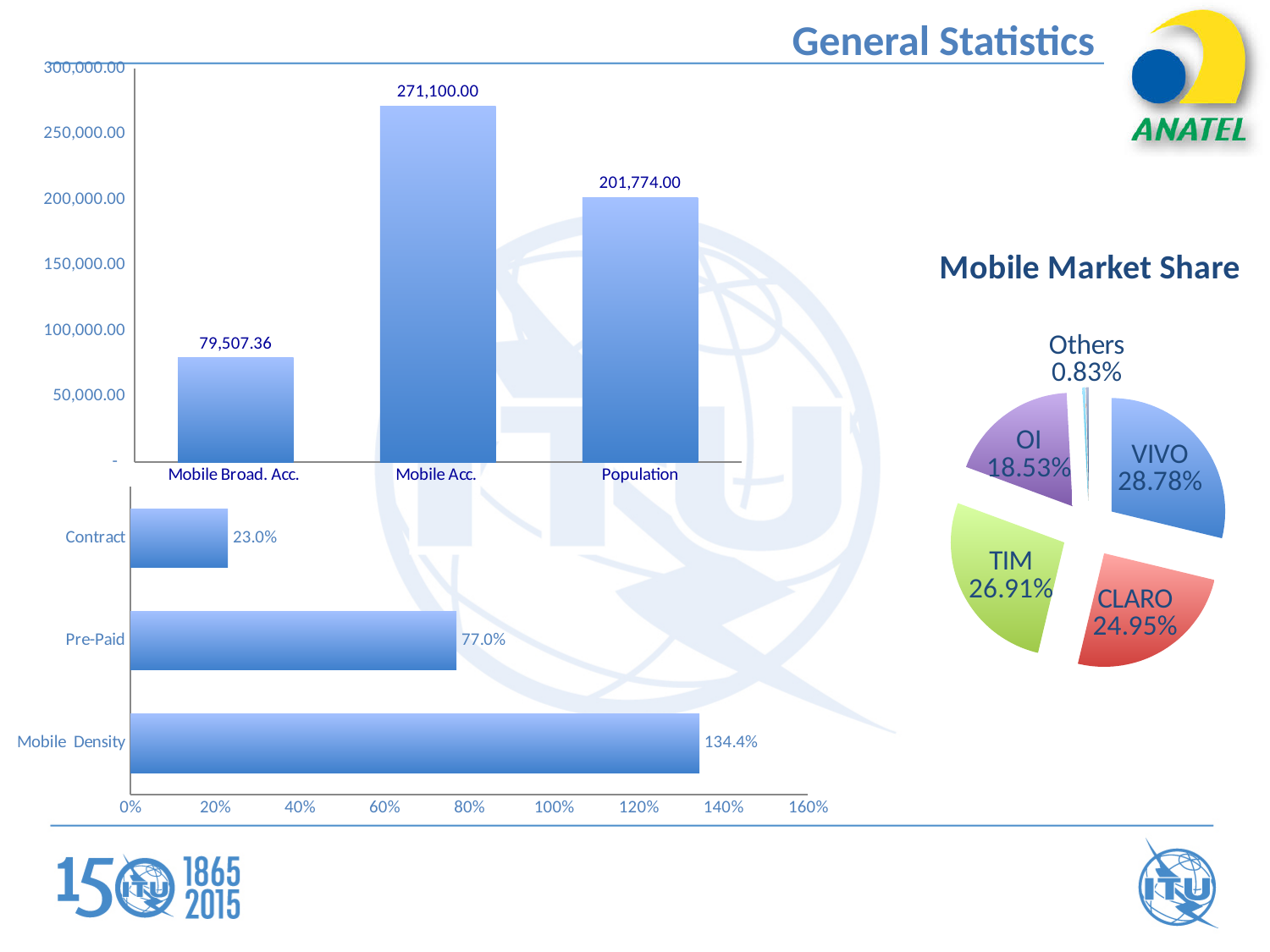
In the Mobile Market Share pie chart, which slice is the largest? VIVO In the top-left vertical bar chart, what is the difference between Mobile Acc. and Population? 69,326.00 In the top-left vertical bar chart, what is the value for Mobile Acc.? 271,100.00 In the bottom-left horizontal bar chart, what kind of chart is it? bar chart In the top-left vertical bar chart, what is the value for Mobile Broad. Acc.? 79,507.36 In the Mobile Market Share pie chart, which is larger, CLARO or OI? CLARO In the bottom-left horizontal bar chart, which category has the lowest value? Contract In the Mobile Market Share pie chart, what share does TIM have? 26.91% In the bottom-left horizontal bar chart, is the value for Mobile Density greater or less than 120%? greater In the top-left vertical bar chart, which category has the highest value? Mobile Acc. In the top-left vertical bar chart, how many categories are shown? 3 In the bottom-left horizontal bar chart, what is the value for Pre-Paid? 77.0%